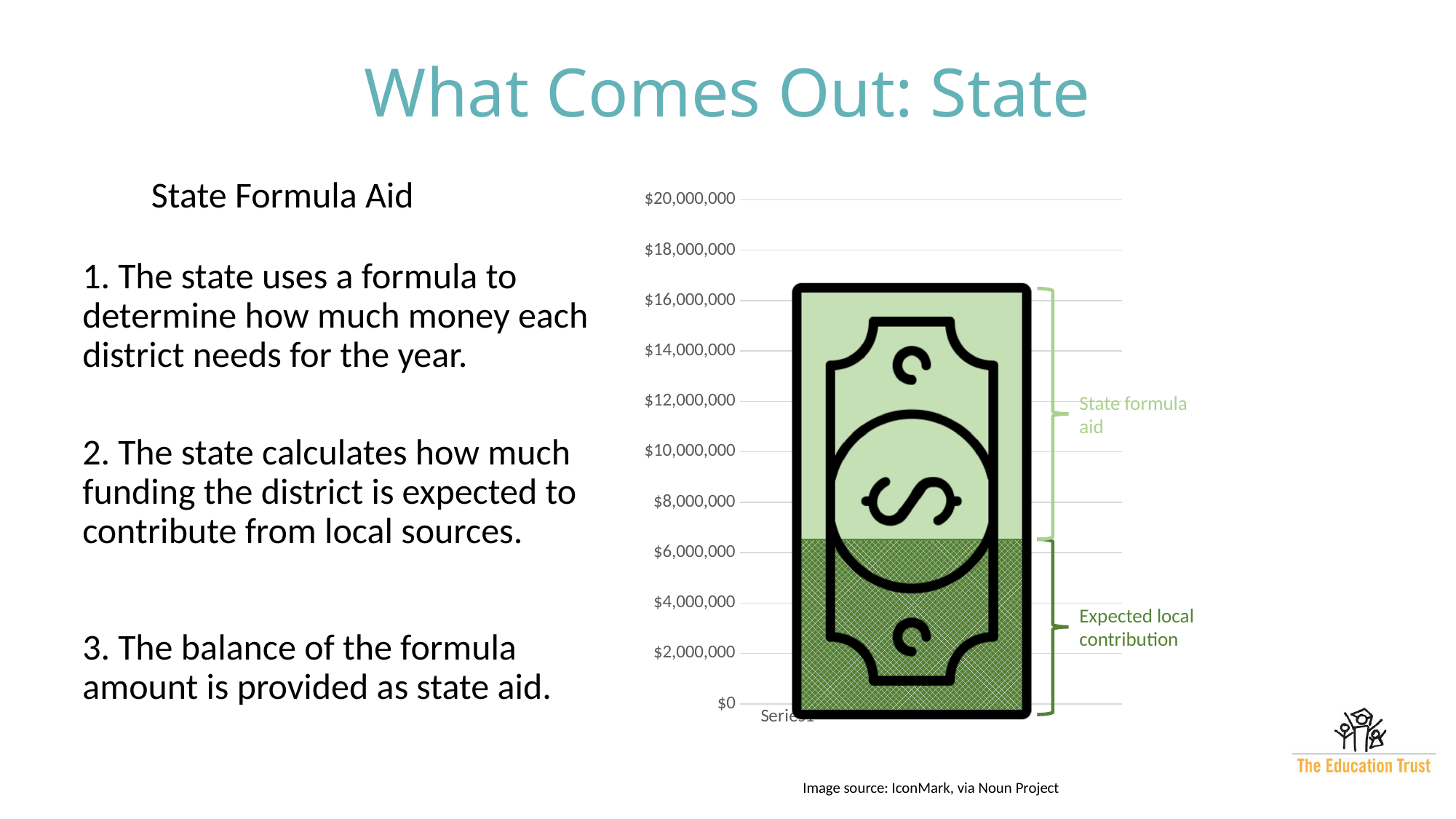
Is the Expected local contribution segment greater or less than $8,000,000? less Which segment of the stacked bar is larger, State formula aid or Expected local contribution? State formula aid Is the total height of the stacked bar greater or less than $18,000,000? less Is the total height of the stacked bar greater or less than $14,000,000? greater How many segments make up the stacked bar in the chart? 2 How many bars does the chart contain? 1 What kind of chart is shown on the slide? bar chart What is the highest value shown on the vertical axis of the chart? $20,000,000 Which segment is at the bottom of the stacked bar? Expected local contribution